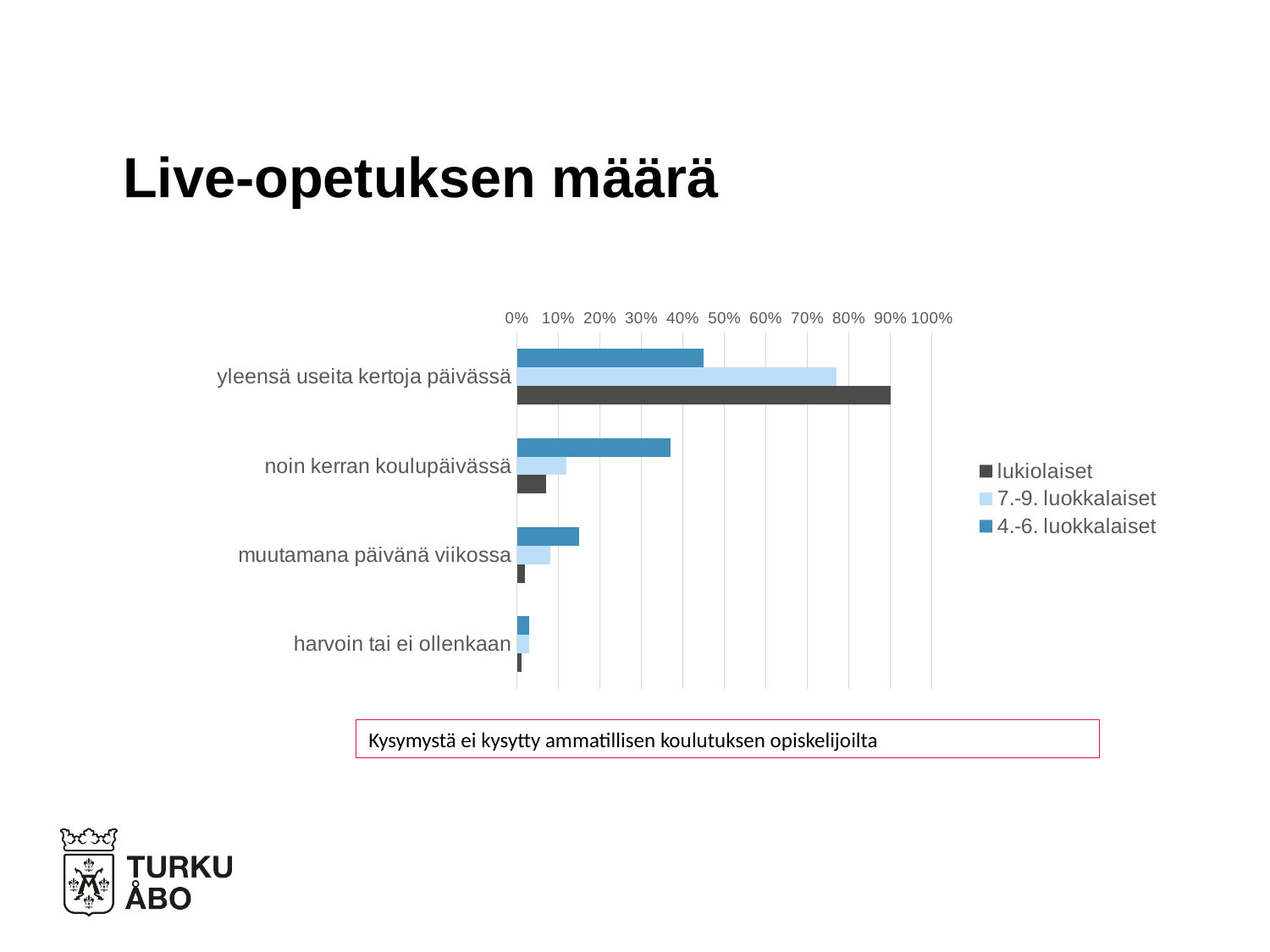
In 'yleensä useita kertoja päivässä', which series has the larger value: 7.-9. luokkalaiset or 4.-6. luokkalaiset? 7.-9. luokkalaiset Is the value for 4.-6. luokkalaiset in 'noin kerran koulupäivässä' greater or less than 30%? greater Which category has the lowest value for 4.-6. luokkalaiset? harvoin tai ei ollenkaan Is the value for 4.-6. luokkalaiset in 'yleensä useita kertoja päivässä' greater or less than 50%? less Is the value for lukiolaiset in 'yleensä useita kertoja päivässä' greater or less than 80%? greater In 'noin kerran koulupäivässä', which series has the larger value: 4.-6. luokkalaiset or lukiolaiset? 4.-6. luokkalaiset What is the title of the slide containing the chart? Live-opetuksen määrä How many series does the chart legend list? 3 What kind of chart is shown on the slide? bar chart How many categories are shown on the vertical axis of the chart? 4 Which category has the highest value for lukiolaiset? yleensä useita kertoja päivässä